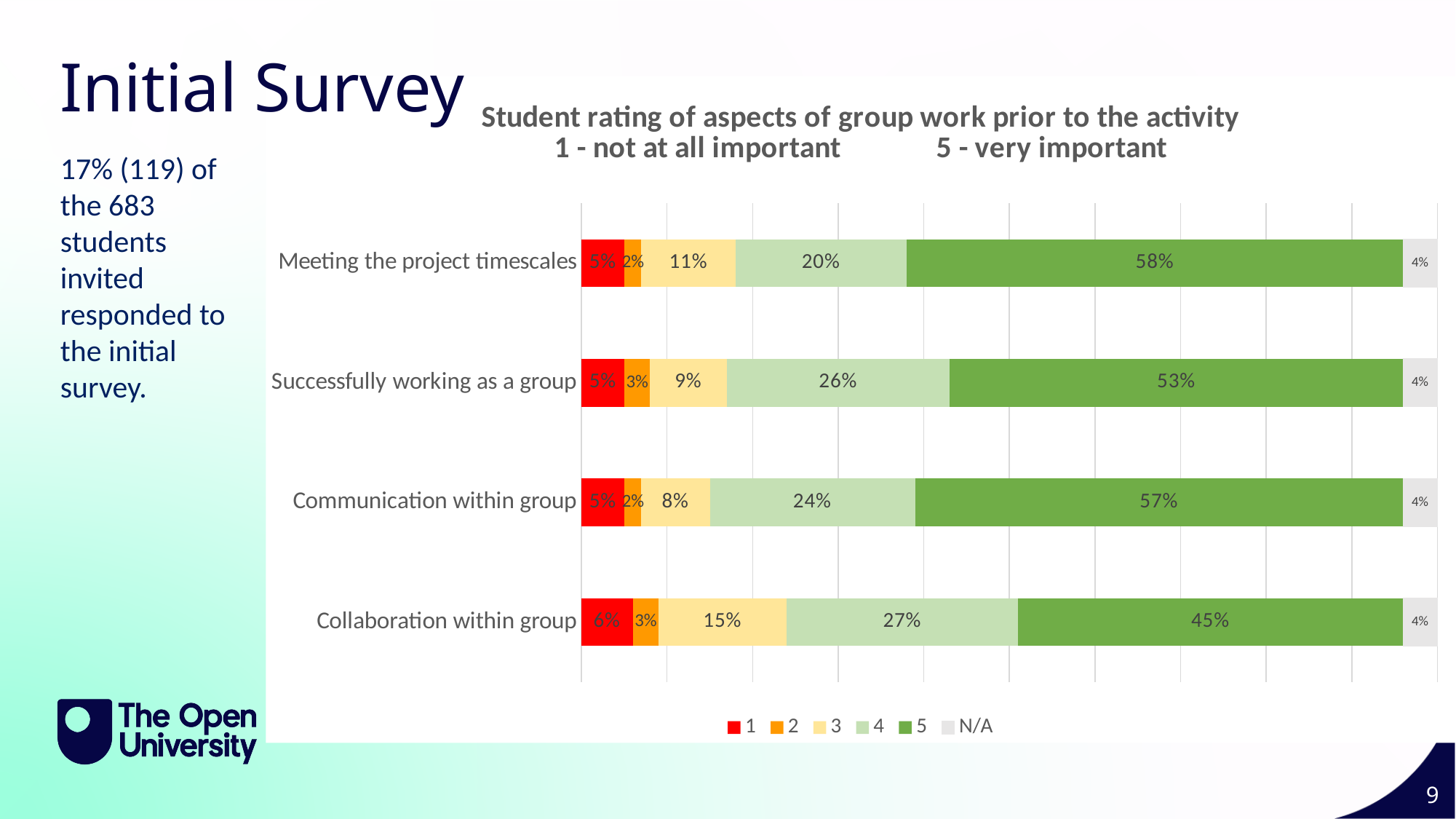
What is the difference between the rating-5 percentage for 'Meeting the project timescales' and for 'Collaboration within group'? 13% Which aspect of group work has the highest percentage of students rating it 5? Meeting the project timescales What is the total of all segments in the 'Collaboration within group' bar? 100% What percentage of students rated 'Communication within group' as 1 (not at all important)? 5% How many series does the chart legend list? 6 Which has a larger rating-4 percentage: 'Collaboration within group' or 'Meeting the project timescales'? Collaboration within group How many aspects of group work are shown in the chart? 4 What percentage of students rated 'Successfully working as a group' as 4? 26% What percentage of students gave 'Collaboration within group' a rating of 3? 15% What type of chart is shown on the slide? Stacked bar chart What percentage of students rated 'Meeting the project timescales' as 5 (very important)? 58% Which aspect of group work has the lowest percentage of students rating it 5? Collaboration within group